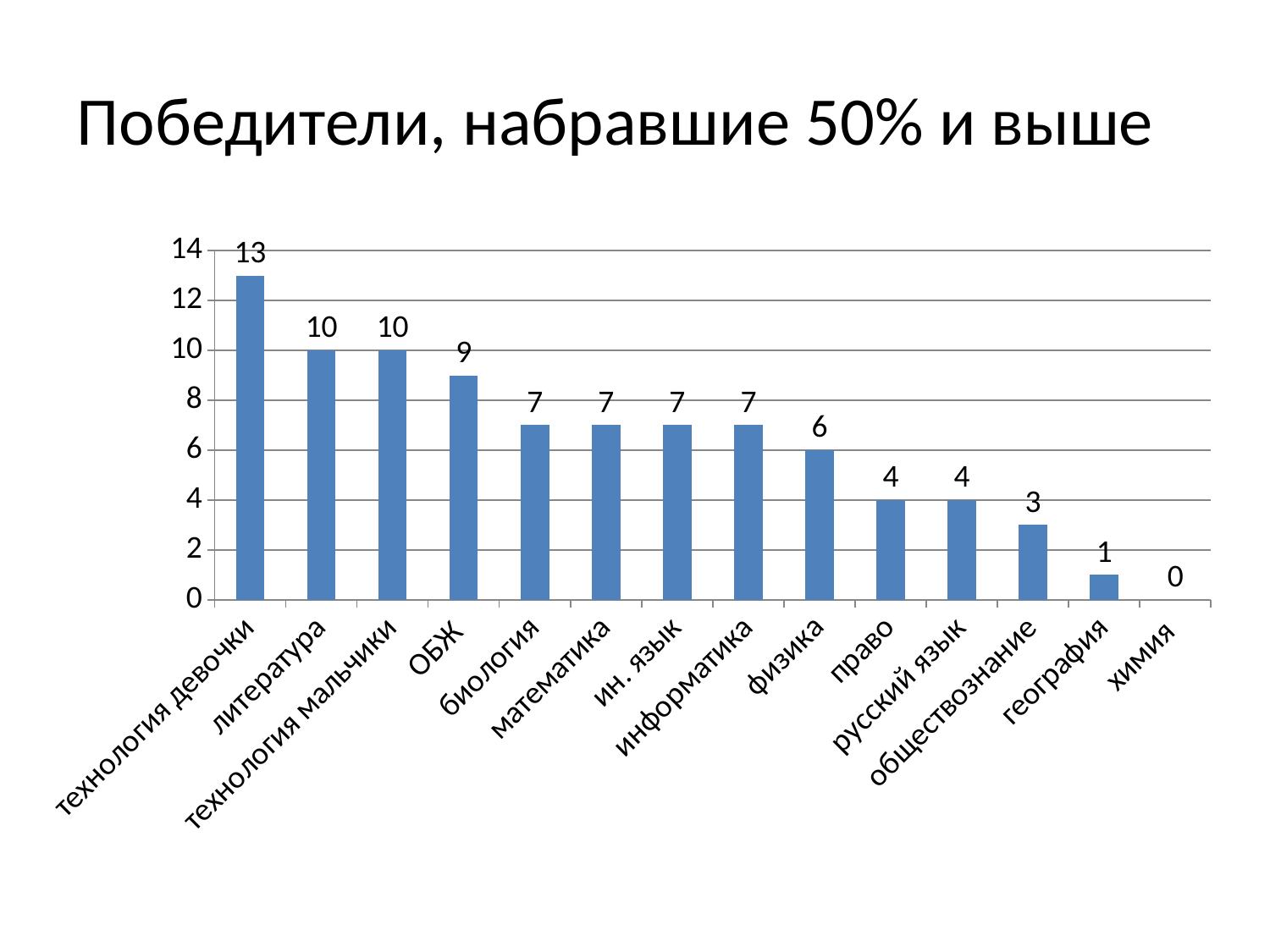
What is the difference between the values for ОБЖ and обществознание? 6 Which is larger, the value for физика or the value for право? физика What is the value for география? 1 Which category has the highest value? технология девочки What is the value for технология девочки? 13 What is the value for физика? 6 What is the title of the slide? Победители, набравшие 50% и выше What is the value for ОБЖ? 9 What kind of chart is shown on the slide? bar chart What is the difference between the values for технология девочки and литература? 3 How many categories are shown on the x axis? 14 Which category has the lowest value? химия